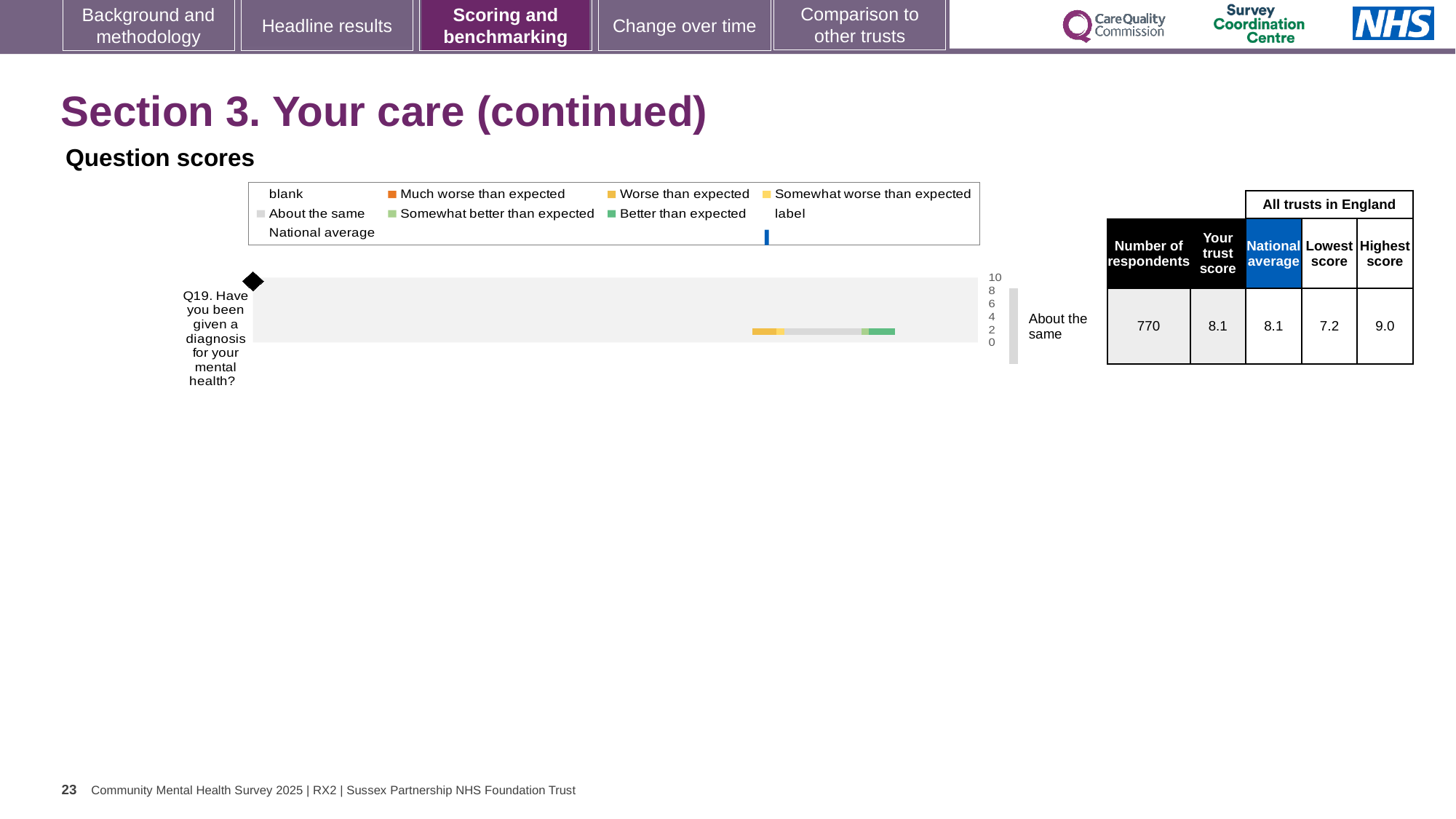
What is the highest score among all trusts in England for Q19? 9.0 What is the national average for Q19? 8.1 How much higher is the trust score for Q19 than the lowest score? 0.9 What kind of chart is shown under 'Question scores'? bar chart How many questions are plotted in the Question scores chart? 1 Is the trust score for Q19 higher than, lower than, or the same as the national average? the same Which benchmark category is Q19 placed in? About the same What is the difference between the highest score and the lowest score for Q19? 1.8 How many respondents answered Q19? 770 What is the trust score for Q19 in the Question scores chart? 8.1 What is the lowest score among all trusts in England for Q19? 7.2 What is the maximum value shown on the score axis of the Question scores chart? 10